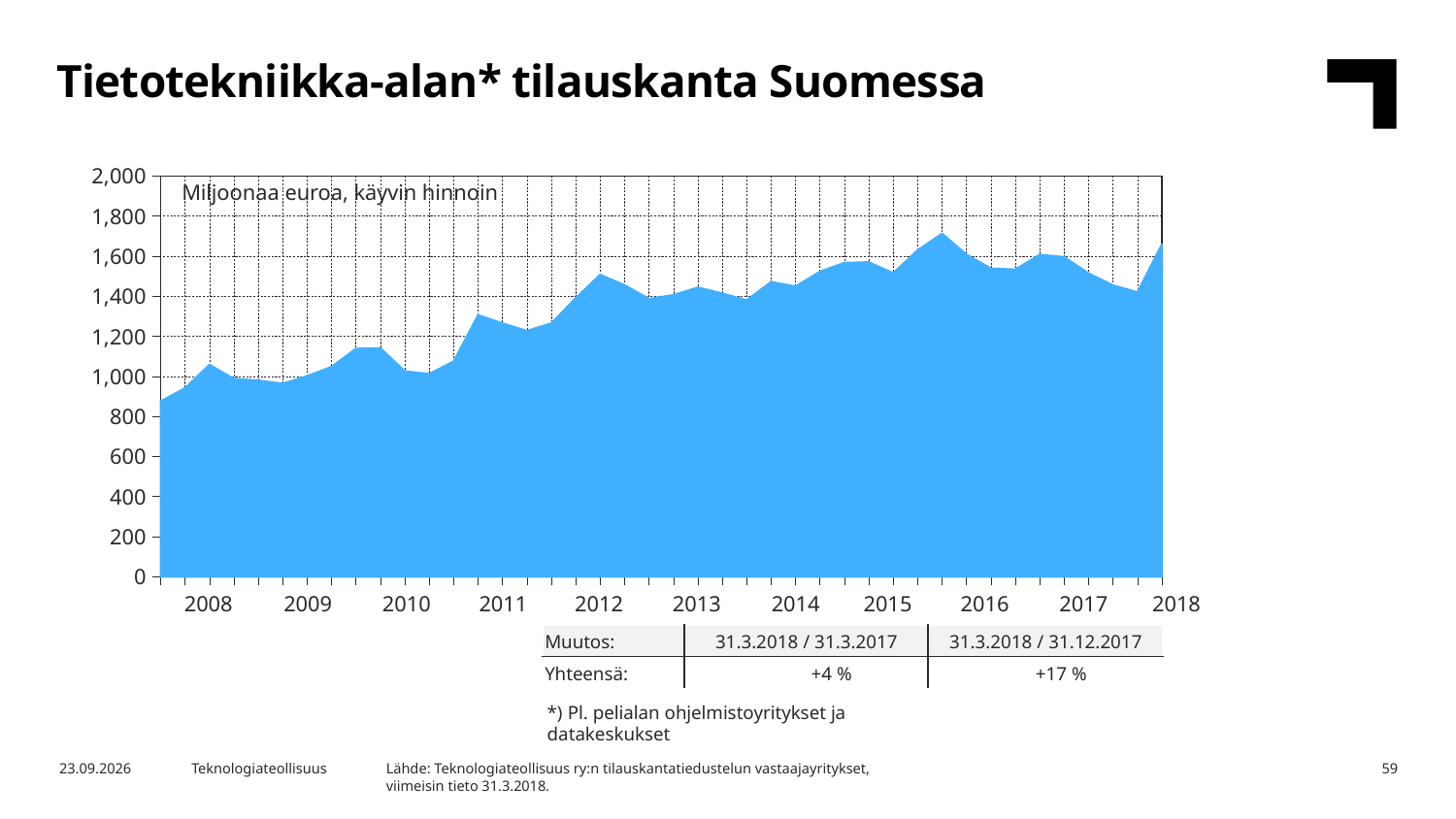
What unit is stated inside the chart area? Miljoonaa euroa, käyvin hinnoin What is the change (Muutos) for 31.3.2018 / 31.12.2017 shown in the table below the chart? +17 % Is the highest point of the series greater or less than 1,600? greater What is the title of the slide's chart? Tietotekniikka-alan* tilauskanta Suomessa Is the value at the start of 2008 greater or less than 1,000? less Overall, do the values rise or fall from 2008 to 2018? Rise Is the value at the start of 2012 greater or less than 1,200? greater What is the change (Muutos) for 31.3.2018 / 31.3.2017 shown in the table below the chart? +4 % What kind of chart is shown on the slide? Area chart How many year labels are shown on the x axis? 11